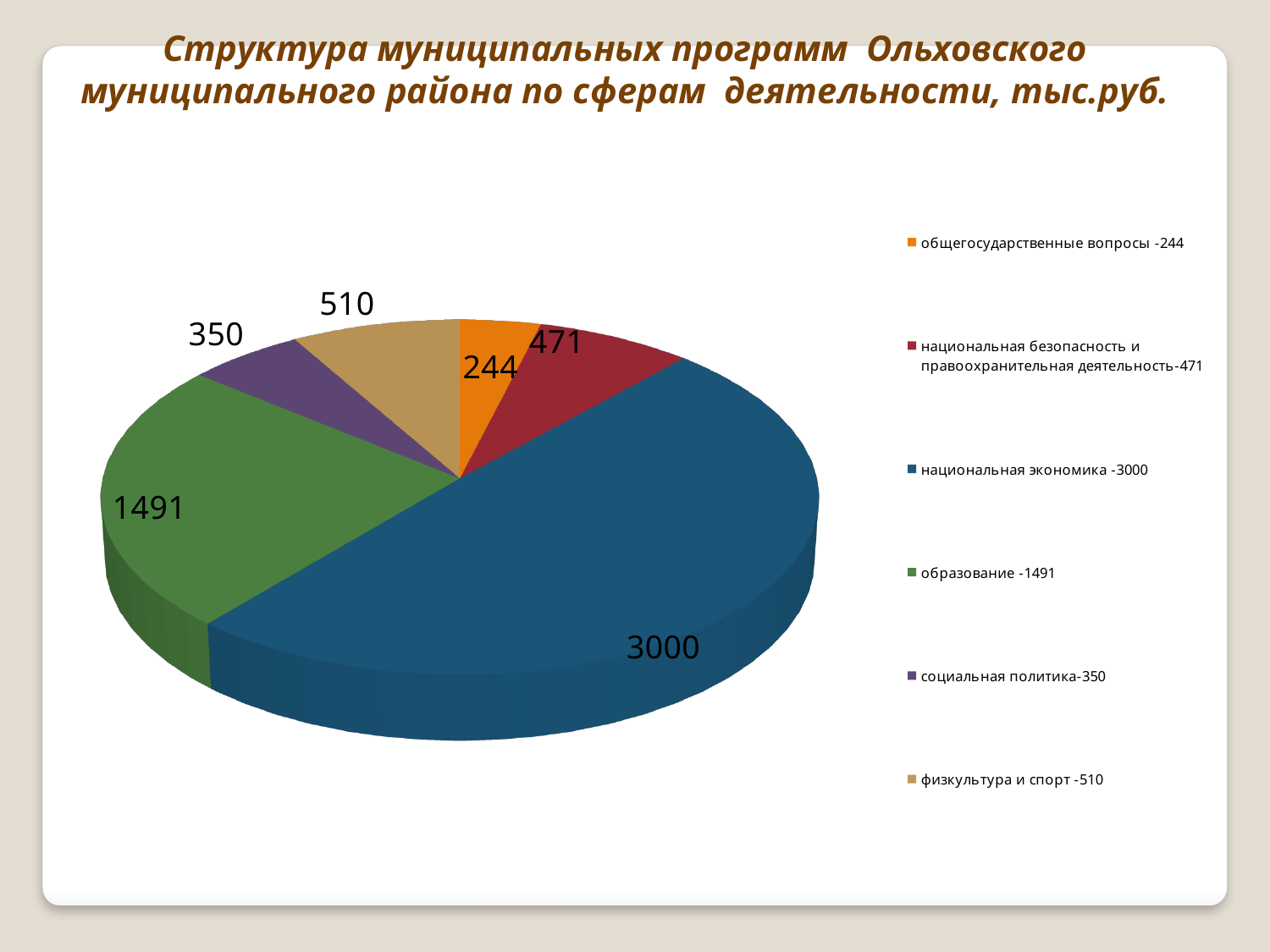
What unit is stated in the chart title for the values? тыс.руб. How many categories does the pie chart have? 6 What is the difference between the values for национальная экономика and образование? 1509 What is the total of all the values shown in the pie chart? 6066 What is the value for национальная экономика? 3000 Which category has the smallest slice of the pie? общегосударственные вопросы What is the value for общегосударственные вопросы? 244 What is the value for образование? 1491 What kind of chart is shown on the slide? Pie chart Which category has the largest slice of the pie? национальная экономика Which is larger, the value for социальная политика or the value for национальная безопасность и правоохранительная деятельность? национальная безопасность и правоохранительная деятельность What is the value for физкультура и спорт? 510